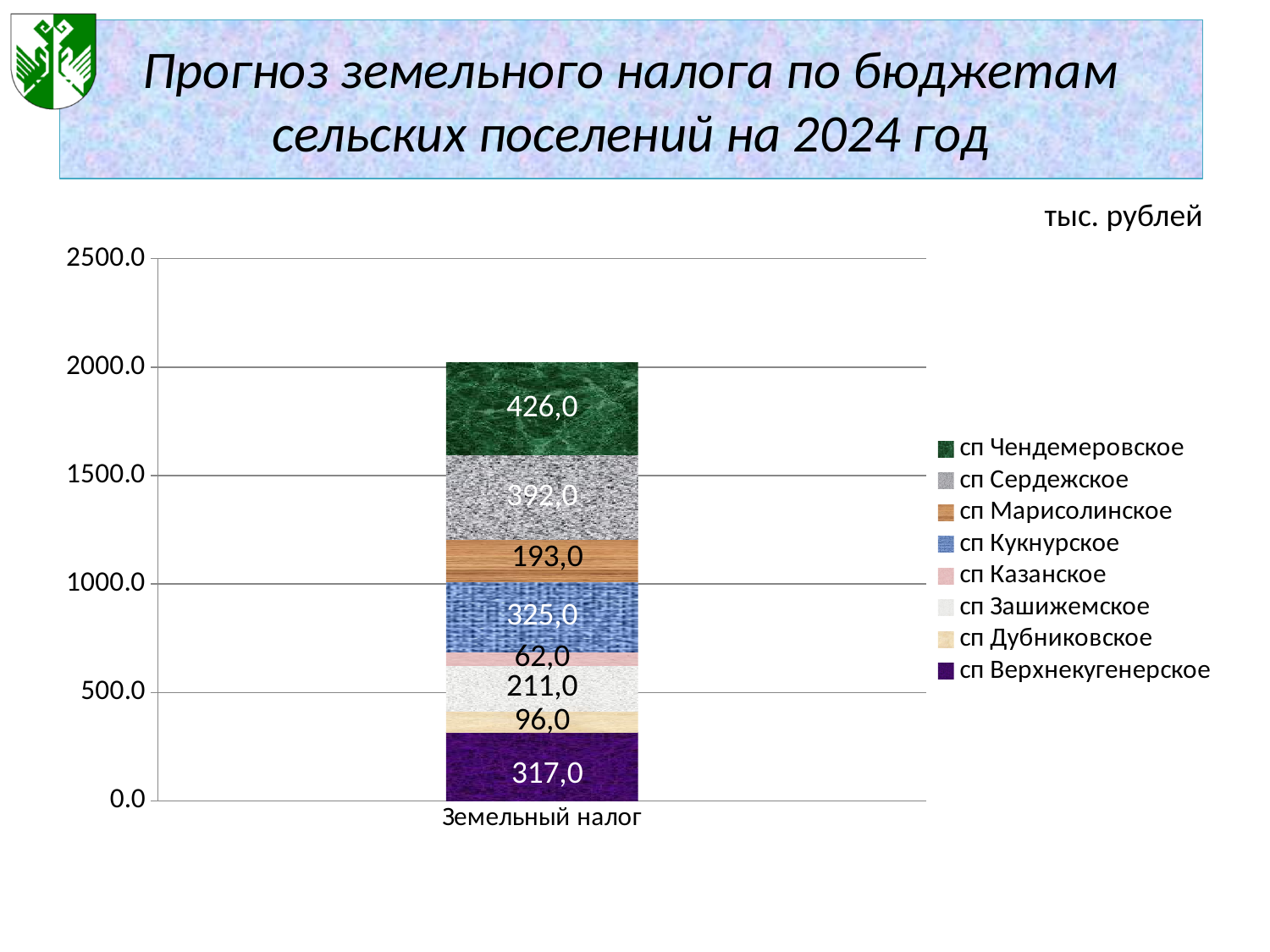
What unit of measurement is indicated above the chart? тыс. рублей Which is larger, the value for сп Зашижемское or the value for сп Марисолинское? сп Зашижемское Which settlement has the lowest land tax forecast value? сп Казанское What kind of chart is shown on the slide? stacked bar chart What is the difference between the values for сп Чендемеровское and сп Сердежское? 34,0 What value is shown for сп Верхнекугенерское? 317,0 What is the total of all segments in the stacked bar? 2022,0 What value is shown for сп Кукнурское? 325,0 What value is shown for сп Чендемеровское in the stacked bar? 426,0 How many series does the legend list? 8 Is the total height of the stacked bar greater or less than 2000? greater Which settlement has the highest land tax forecast value? сп Чендемеровское